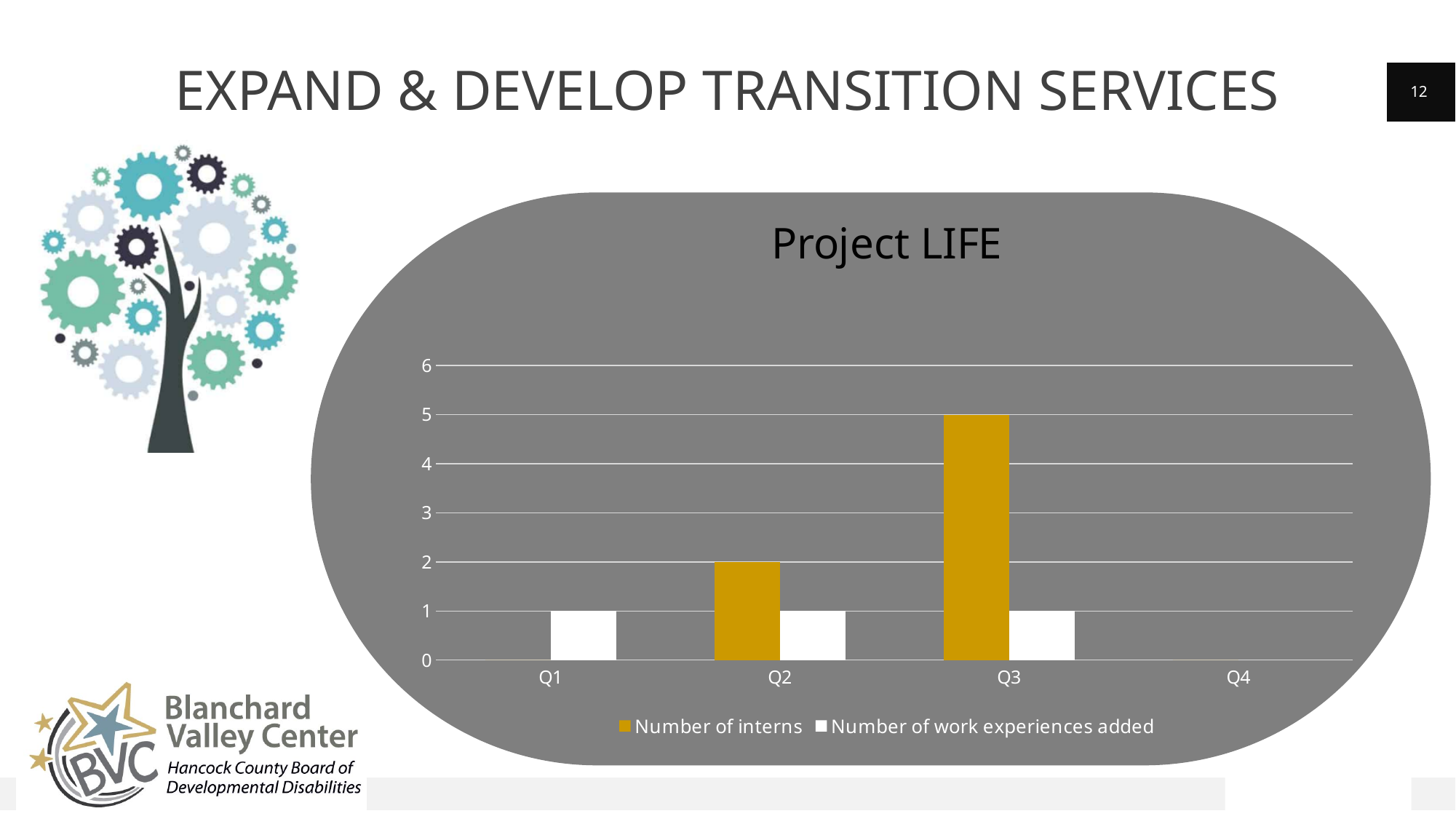
In which quarter is the Number of interns highest? Q3 What is the Number of interns in Q3? 5 What is the Number of interns in Q2? 2 What is the title of the chart? Project LIFE In Q2, which is larger: Number of interns or Number of work experiences added? Number of interns What is the difference between the Number of interns in Q3 and in Q2? 3 Which colour represents the Number of interns series? gold How many quarters are shown on the x axis? 4 What is the Number of work experiences added in Q1? 1 How many series does the legend list? 2 What type of chart is shown on the slide? bar chart Is the Number of interns in Q3 greater or less than 4? greater